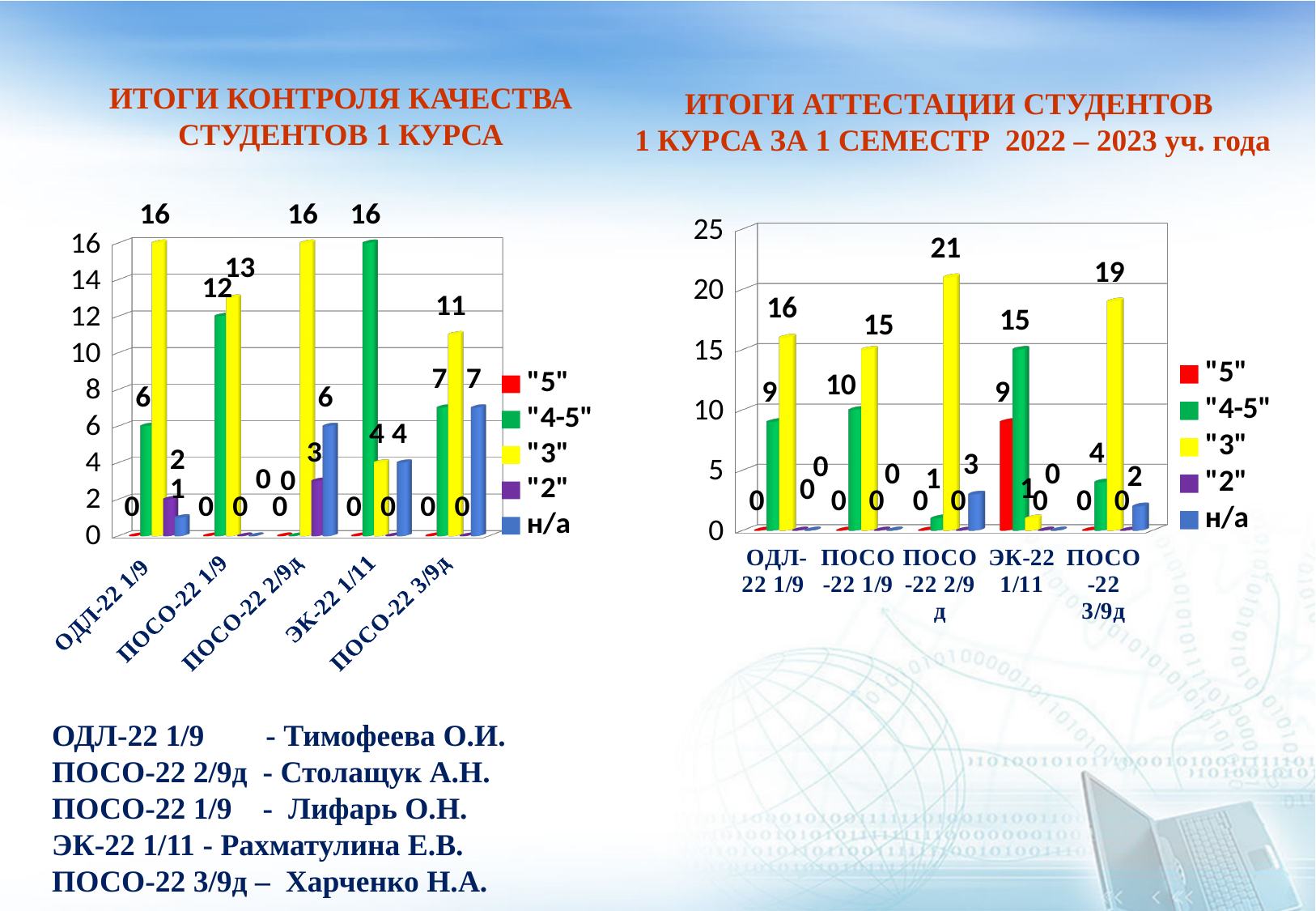
In the right chart (ИТОГИ АТТЕСТАЦИИ СТУДЕНТОВ 1 КУРСА ЗА 1 СЕМЕСТР), what is the difference between the "3" value and the "4-5" value for ОДЛ-22 1/9? 7 In the right chart (ИТОГИ АТТЕСТАЦИИ СТУДЕНТОВ 1 КУРСА ЗА 1 СЕМЕСТР), what is the value of the "3" series for ПОСО-22 2/9д? 21 What type of chart is the right chart (ИТОГИ АТТЕСТАЦИИ СТУДЕНТОВ 1 КУРСА ЗА 1 СЕМЕСТР)? Bar chart In the left chart (ИТОГИ КОНТРОЛЯ КАЧЕСТВА СТУДЕНТОВ 1 КУРСА), what is the value of the "3" series for ОДЛ-22 1/9? 16 In the right chart (ИТОГИ АТТЕСТАЦИИ СТУДЕНТОВ 1 КУРСА ЗА 1 СЕМЕСТР), which is larger for ПОСО-22 1/9: the "4-5" value or the "3" value? "3" In the left chart (ИТОГИ КОНТРОЛЯ КАЧЕСТВА СТУДЕНТОВ 1 КУРСА), what is the value of the "4-5" series for ПОСО-22 1/9? 12 In the right chart (ИТОГИ АТТЕСТАЦИИ СТУДЕНТОВ 1 КУРСА ЗА 1 СЕМЕСТР), how many student groups are shown on the x axis? 5 In the left chart (ИТОГИ КОНТРОЛЯ КАЧЕСТВА СТУДЕНТОВ 1 КУРСА), how many series does the legend list? 5 In the right chart (ИТОГИ АТТЕСТАЦИИ СТУДЕНТОВ 1 КУРСА ЗА 1 СЕМЕСТР), which group has the highest value in the "5" series? ЭК-22 1/11 In the left chart (ИТОГИ КОНТРОЛЯ КАЧЕСТВА СТУДЕНТОВ 1 КУРСА), which group has the highest value in the "4-5" series? ЭК-22 1/11 In the left chart (ИТОГИ КОНТРОЛЯ КАЧЕСТВА СТУДЕНТОВ 1 КУРСА), what is the н/а value for ПОСО-22 2/9д? 6 In the left chart (ИТОГИ КОНТРОЛЯ КАЧЕСТВА СТУДЕНТОВ 1 КУРСА), what is the difference between the "3" value and the "4-5" value for ПОСО-22 3/9д? 4